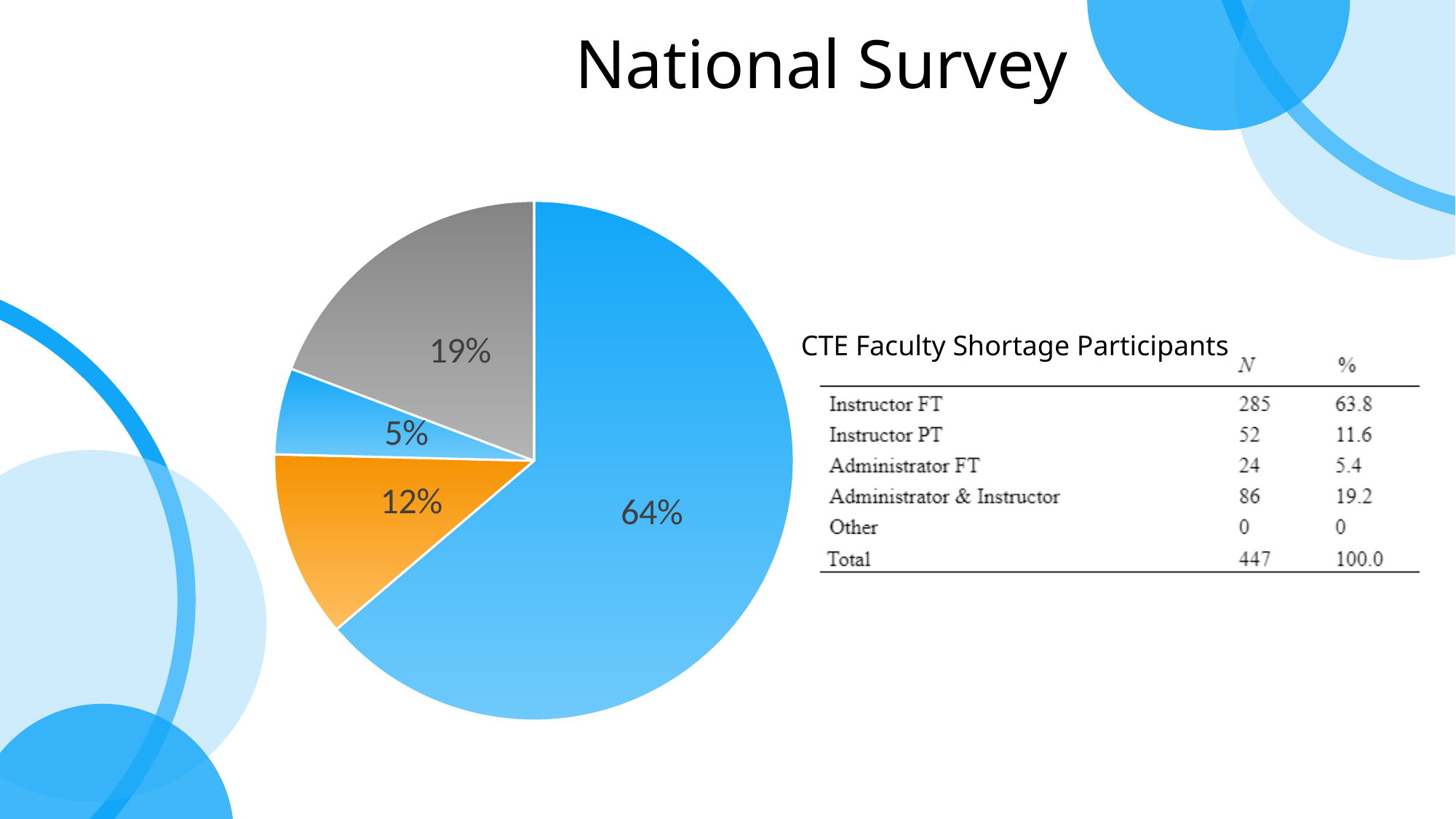
Which slice of the pie chart is larger, the grey slice or the orange slice? the grey slice What percentage is shown on the smallest slice of the pie chart? 5% Is the largest slice of the pie chart greater or less than 50%? greater What colour is the largest slice of the pie chart? blue What is the title of the slide containing the pie chart? National Survey What percentage is shown on the orange slice of the pie chart? 12% What is the difference in percentage points between the grey slice (19%) and the orange slice (12%) of the pie chart? 7 What percentage is shown on the grey slice of the pie chart? 19% What percentage is shown on the largest slice of the pie chart? 64% How many slices does the pie chart have? 4 What percentage is shown on the small light-blue slice of the pie chart? 5% What kind of chart is shown on the slide? pie chart